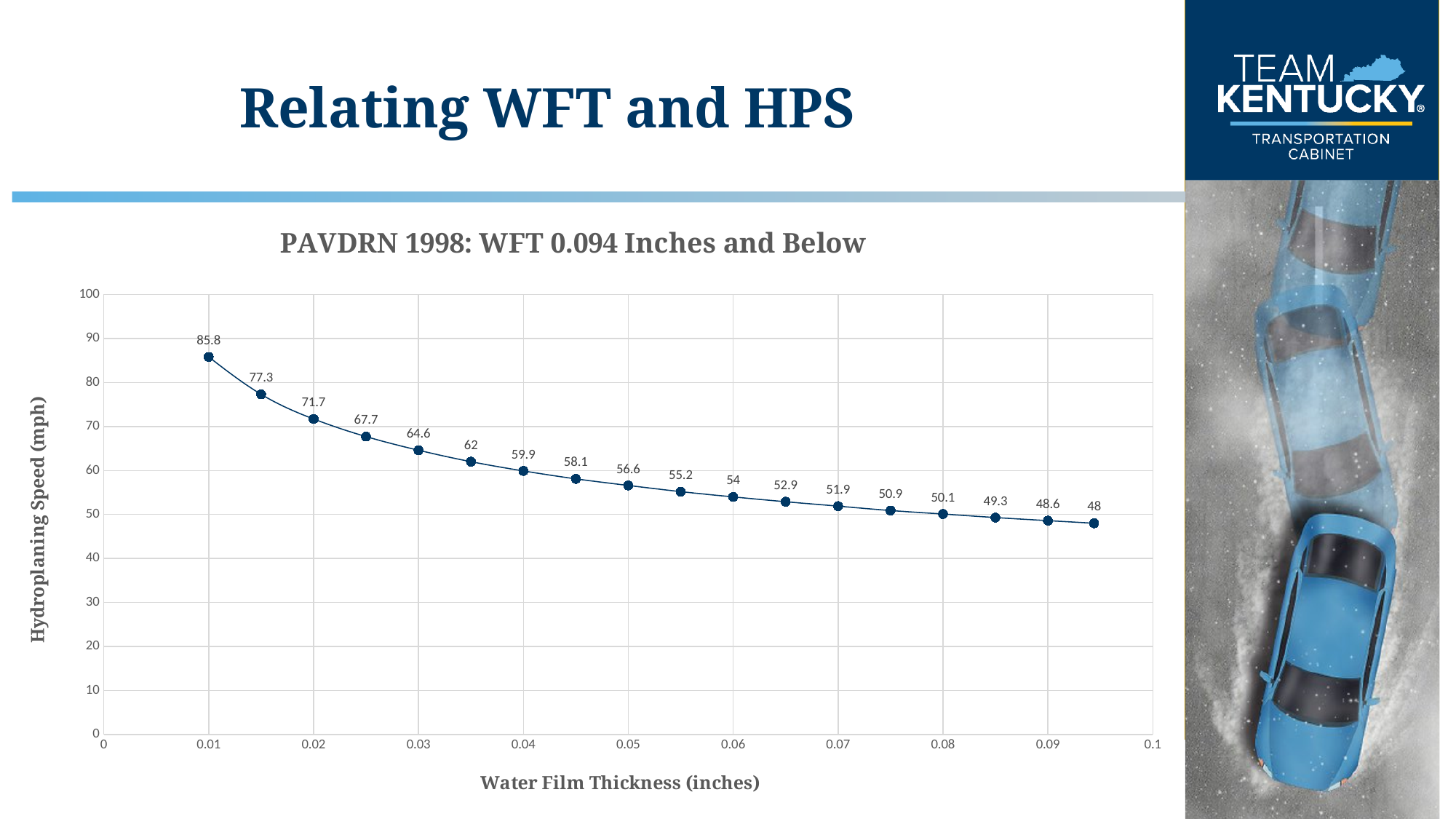
What is the difference between the highest and lowest hydroplaning speed values plotted? 37.8 Which has a higher hydroplaning speed: a water film thickness of 0.02 inches or 0.06 inches? 0.02 inches What is the hydroplaning speed at a water film thickness of 0.01 inches? 85.8 What is the hydroplaning speed at a water film thickness of 0.03 inches? 64.6 Does the hydroplaning speed rise or fall as water film thickness increases? fall How many data points are plotted on the chart? 18 What is the difference in hydroplaning speed between a water film thickness of 0.01 inches and 0.02 inches? 14.1 What is the lowest hydroplaning speed value plotted on the chart? 48 What is the hydroplaning speed at a water film thickness of 0.05 inches? 56.6 What is the title of the chart? PAVDRN 1998: WFT 0.094 Inches and Below What is the highest hydroplaning speed value plotted on the chart? 85.8 Is the hydroplaning speed at a water film thickness of 0.04 inches greater or less than 50? greater